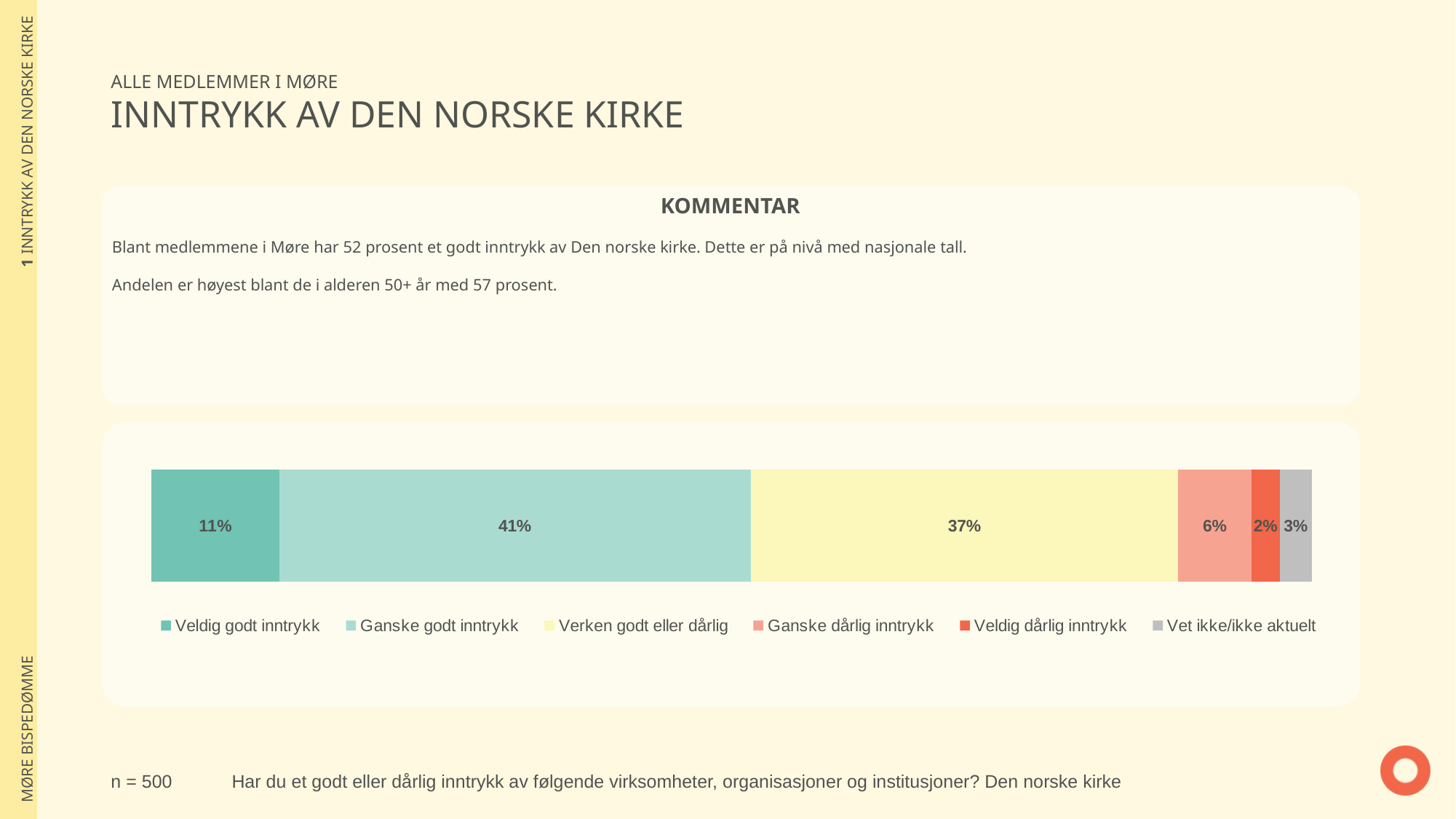
How many series does the legend list? 6 What percentage of respondents answered "Vet ikke/ikke aktuelt"? 3% What kind of chart is shown on the slide? Stacked bar chart What percentage of respondents answered "Ganske godt inntrykk"? 41% Which is larger, the share for "Ganske dårlig inntrykk" or for "Vet ikke/ikke aktuelt"? Ganske dårlig inntrykk Which response category has the smallest share? Veldig dårlig inntrykk What is the combined share of "Veldig godt inntrykk" and "Ganske godt inntrykk"? 52% Which response category has the largest share? Ganske godt inntrykk What percentage of respondents answered "Verken godt eller dårlig"? 37% What is the difference between the shares for "Ganske godt inntrykk" and "Verken godt eller dårlig"? 4 percentage points What percentage of respondents answered "Veldig godt inntrykk"? 11% What colour is the segment for "Veldig dårlig inntrykk"? Red